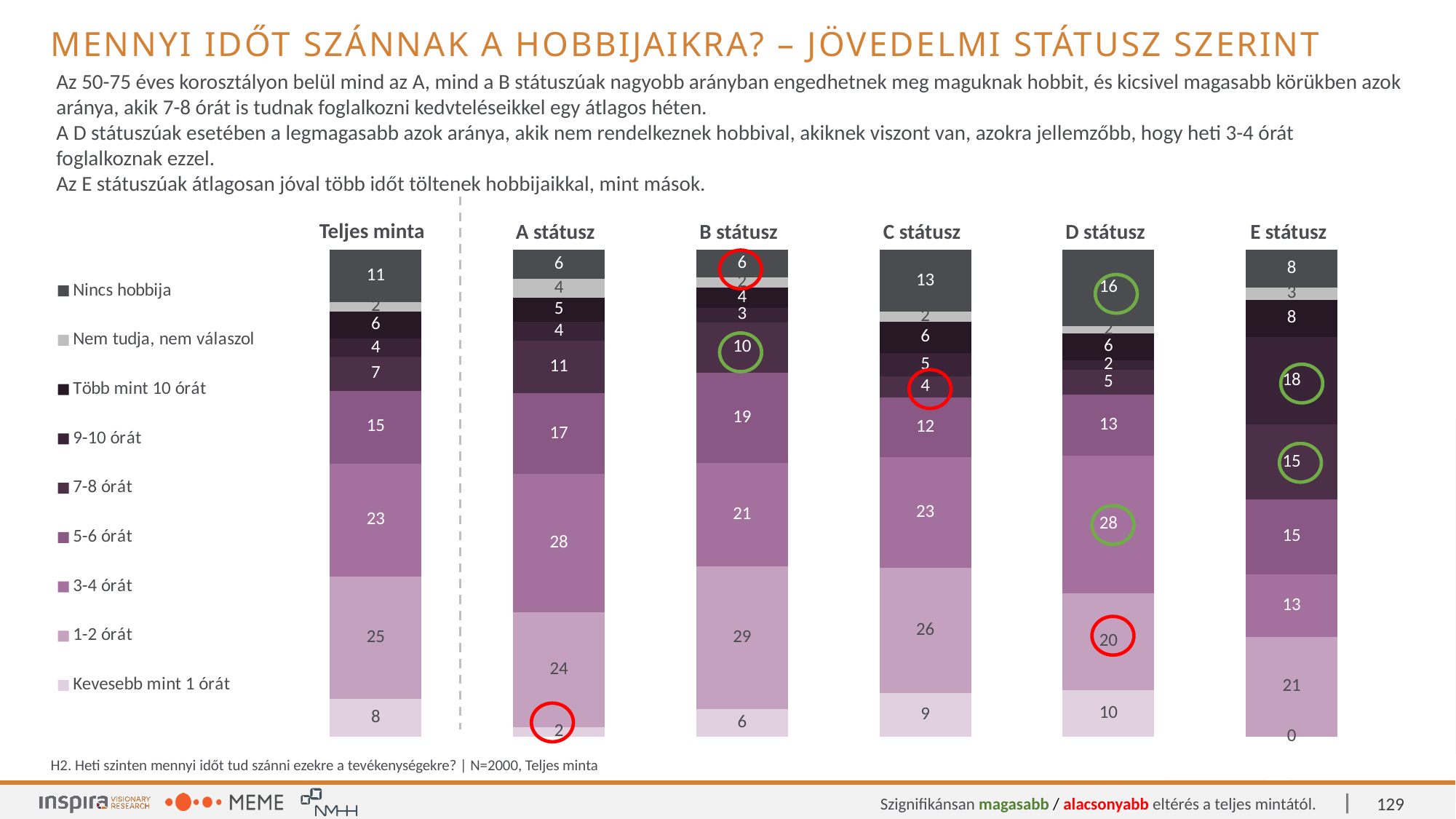
What kind of chart is shown on the slide? Stacked bar chart Which is larger: the '9-10 órát' value for E státusz or for Teljes minta? E státusz What is the total of the B státusz stacked bar? 100 Which legend entry is listed first (at the top) in the legend? Nincs hobbija How many bars (groups) are plotted in the chart? 6 What is the difference between the '3-4 órát' values for A státusz and E státusz? 15 Which bar has the highest value for 'Nincs hobbija'? D státusz What is the value for 'Kevesebb mint 1 órát' in the E státusz bar? 0 What is the value for 'Nincs hobbija' in the D státusz bar? 16 How many series does the legend list? 9 Which bar has the lowest value for 'Kevesebb mint 1 órát'? E státusz What is the value for '1-2 órát' in the B státusz bar? 29